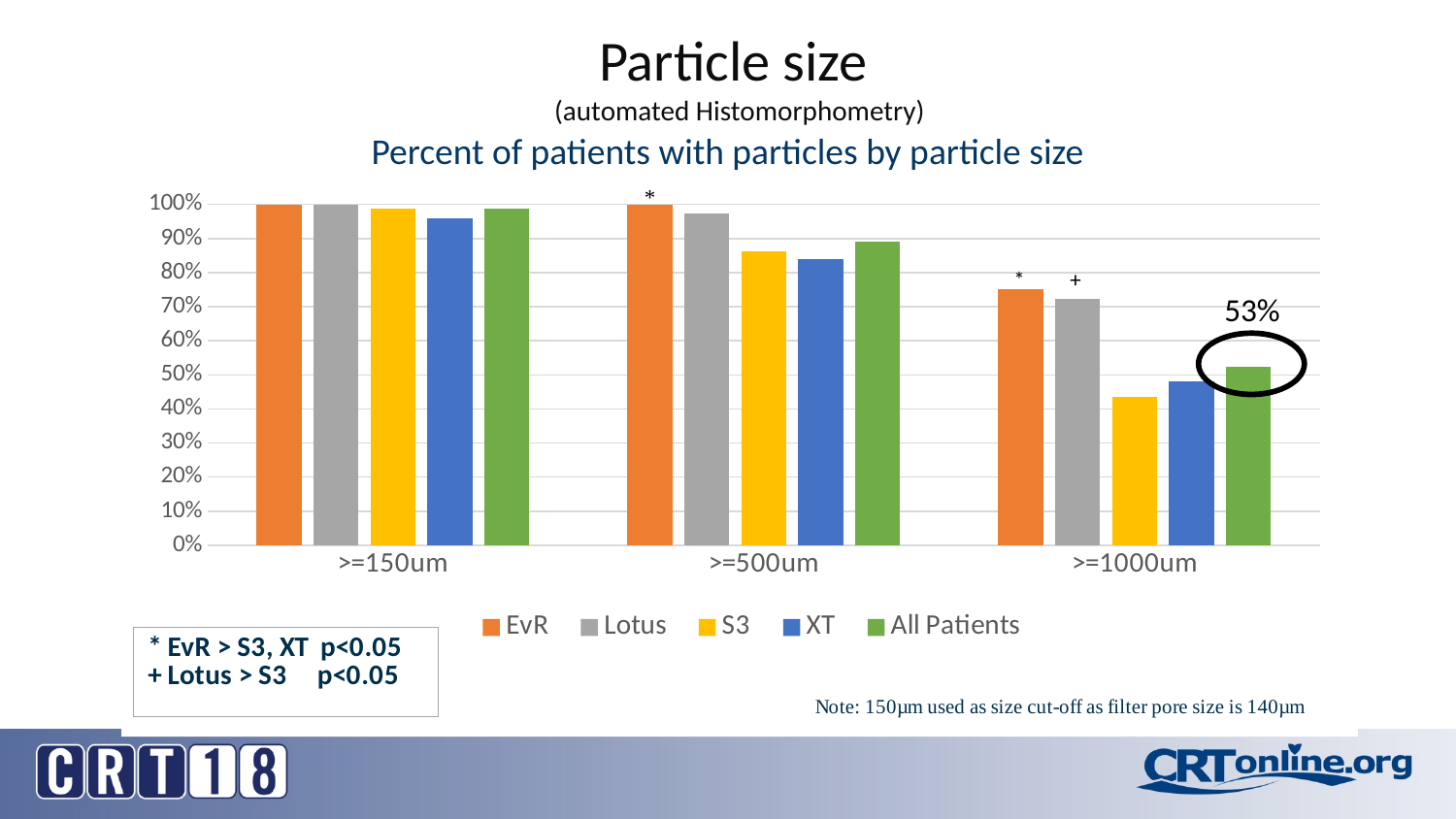
What kind of chart is shown on the slide? bar chart Which colour represents the All Patients series in the legend? green In the >=1000um category, which is larger, the value for Lotus or the value for XT? Lotus Is the value for EvR in the >=1000um category greater or less than 70%? greater What is the value for All Patients in the >=1000um category? 53% Which series has the lowest value in the >=1000um category? S3 Is the value for S3 in the >=1000um category greater or less than 50%? less Do the values for S3 rise or fall as particle size increases from >=150um to >=1000um? fall Is the value for XT in the >=500um category greater or less than 80%? greater Which series has the highest value in the >=1000um category? EvR How many series does the legend list? 5 How many particle-size categories are shown on the x axis? 3